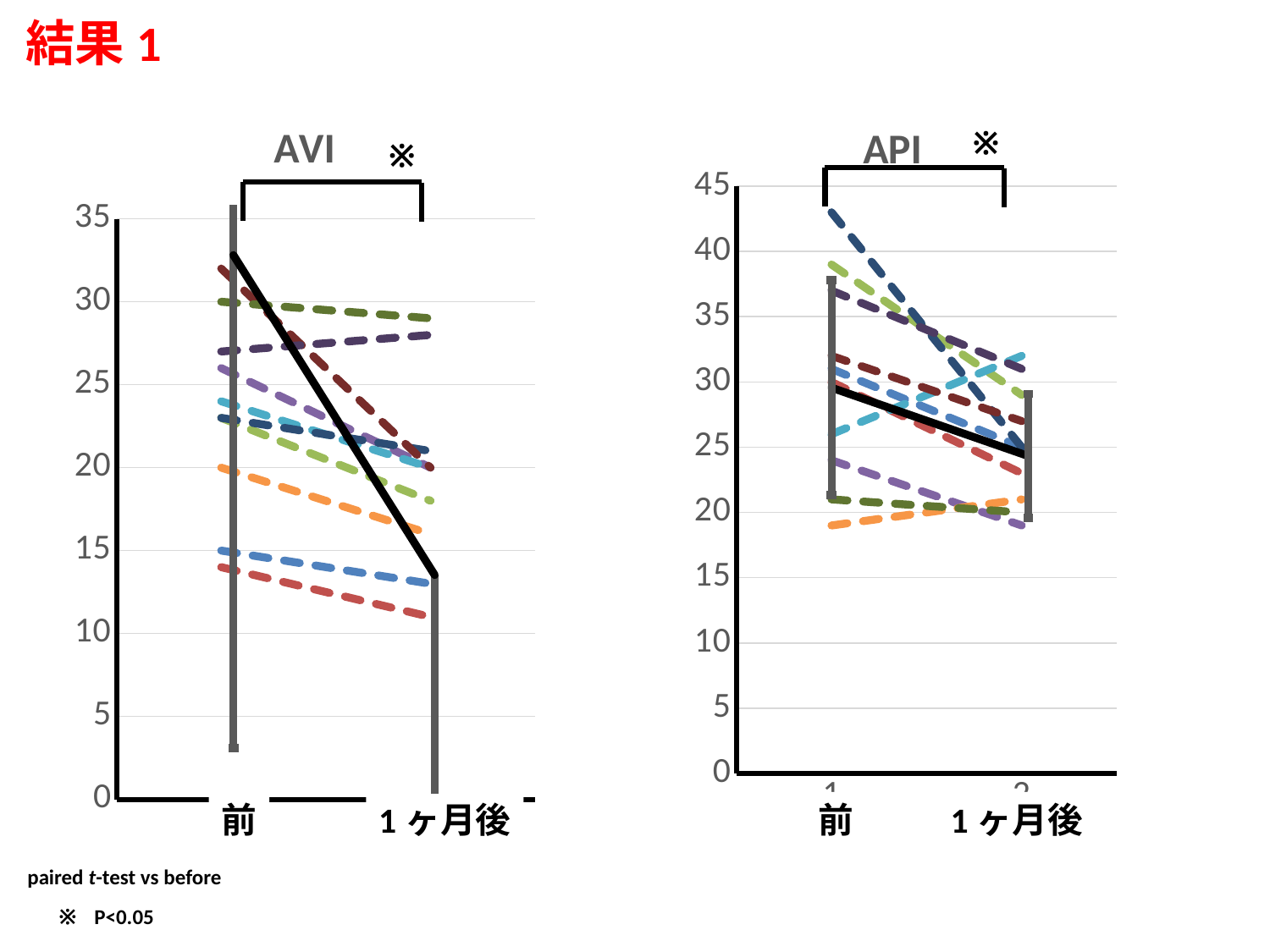
In the AVI chart, does the thick black mean line rise or fall from 前 to 1ヶ月後? fall In the API chart, does the thick black mean line rise or fall from 前 to 1ヶ月後? fall What kind of chart is the API chart on the right? line chart How many categories are shown on the x axis of the API chart? 2 In the AVI chart, is the value of the thick black line at 1ヶ月後 greater or less than 20? less How many categories are shown on the x axis of the AVI chart? 2 What is the title of the chart on the right? API In the API chart, is the value of the thick black line at 1ヶ月後 greater or less than 30? less In the AVI chart, is the value of the thick black line at 前 greater or less than 30? greater What kind of chart is the AVI chart on the left? line chart What significance level does the ※ symbol above the charts indicate? P<0.05